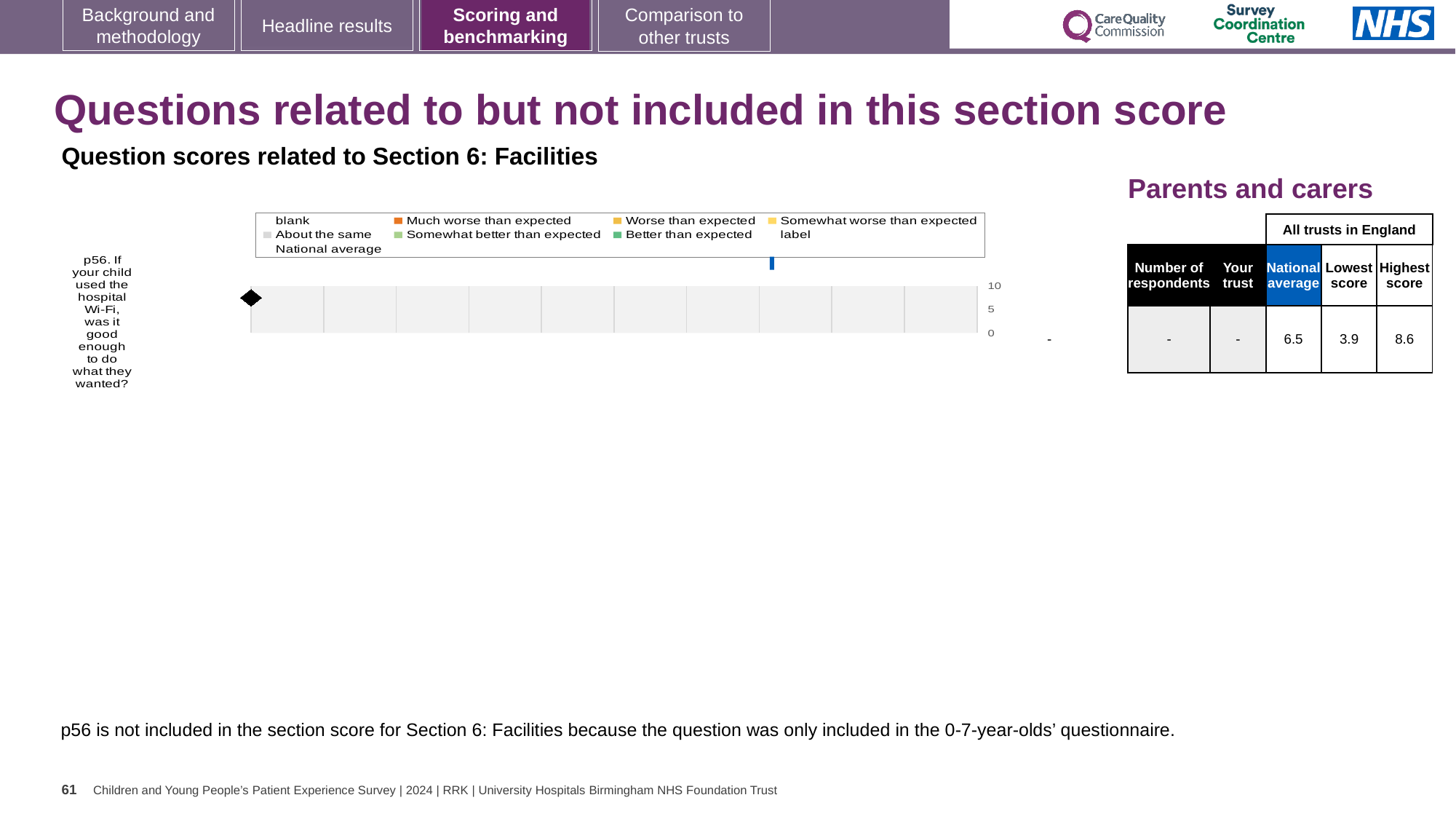
What kind of chart is shown on the slide? bar chart How many questions (categories) are plotted on the chart? 1 What value is shown for 'Your trust' for p56 in the table next to the chart? - What is the highest value shown on the chart's axis? 10 What is the national average score for p56 shown in the table next to the chart? 6.5 What is the highest score across all trusts in England for p56? 8.6 What is the difference between the highest and lowest trust scores for p56? 4.7 What is the lowest score across all trusts in England for p56? 3.9 Which question is plotted on the chart? p56. If your child used the hospital Wi-Fi, was it good enough to do what they wanted? Which is larger for p56: the national average or the lowest score? National average